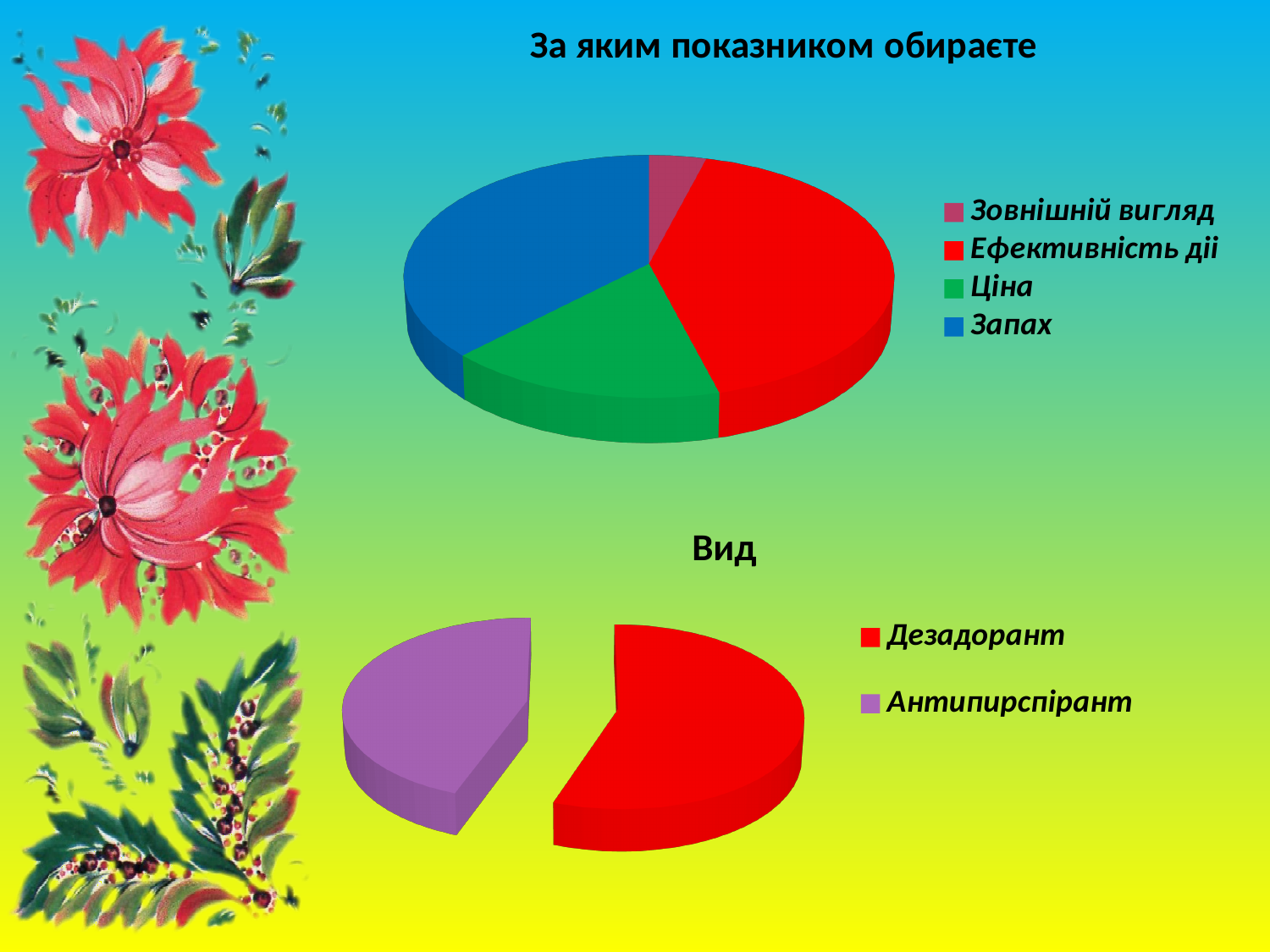
In the top chart "За яким показником обираєте", which slice is larger: Ефективність дії or Зовнішній вигляд? Ефективність дії In the top chart "За яким показником обираєте", what colour is the slice for Ціна? green What is the title of the bottom chart? Вид In the bottom chart "Вид", which category has the larger slice? Дезадорант In the bottom chart "Вид", how many slices does the pie have? 2 In the top chart "За яким показником обираєте", which category has the largest slice? Ефективність дії In the bottom chart "Вид", which category has the smaller slice? Антипирспірант In the top chart "За яким показником обираєте", which category has the smallest slice? Зовнішній вигляд In the top chart "За яким показником обираєте", which slice is larger: Запах or Ціна? Запах In the top chart "За яким показником обираєте", how many slices does the pie have? 4 What kind of chart is the top chart titled "За яким показником обираєте"? pie chart What kind of chart is the bottom chart titled "Вид"? pie chart